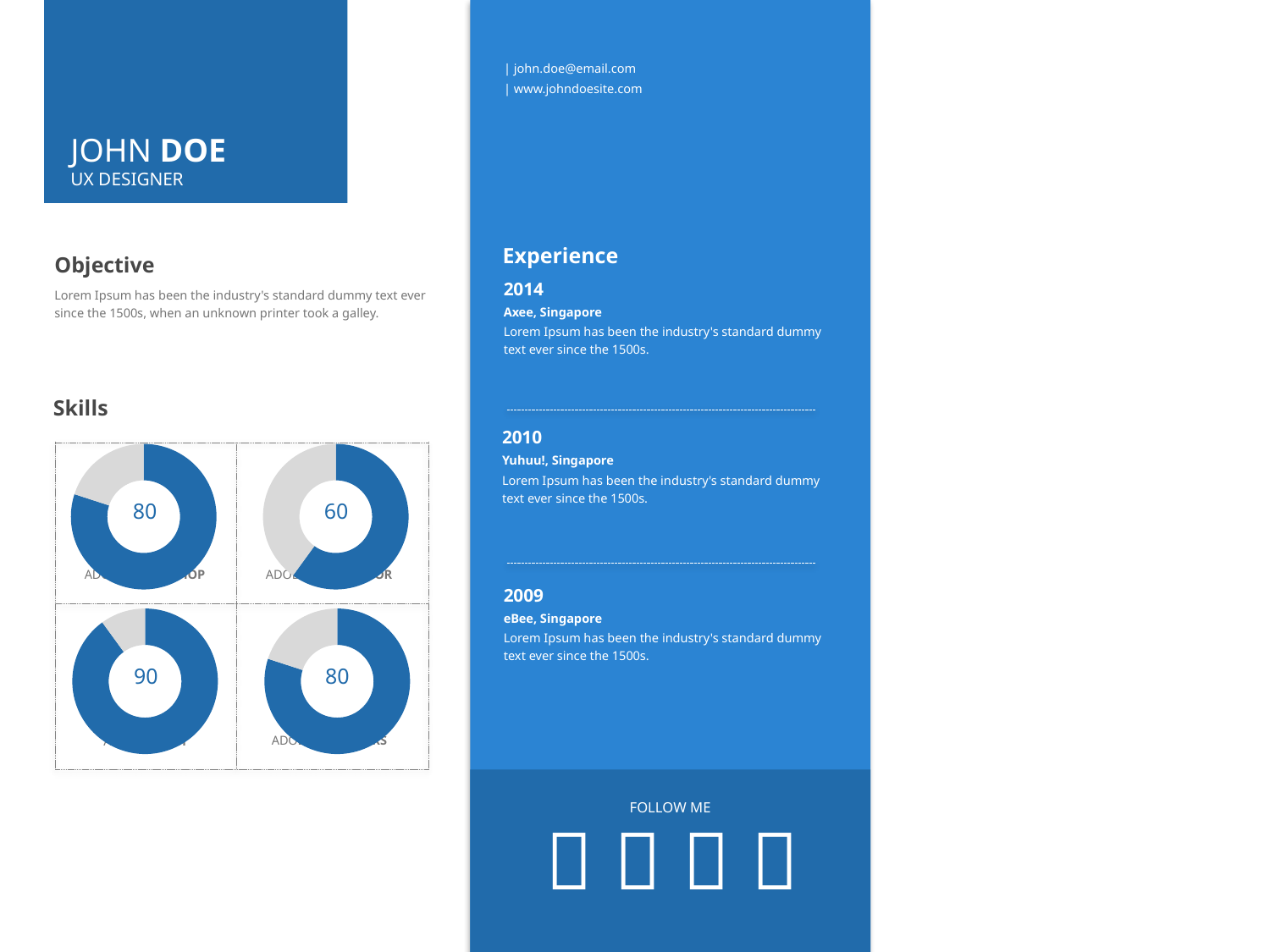
What kind of chart is used for each skill in the Skills section? doughnut chart What colour is the filled portion of the doughnut charts in the Skills section? blue What value is shown in the centre of the top-right doughnut chart in the Skills section? 60 What value is shown in the centre of the top-left doughnut chart in the Skills section? 80 What is the difference between the value in the top-left Skills chart and the value in the top-right Skills chart? 20 Which of the four Skills doughnut charts shows the highest value? bottom-left What value is shown in the centre of the bottom-left doughnut chart in the Skills section? 90 What value is shown in the centre of the bottom-right doughnut chart in the Skills section? 80 How many doughnut charts are shown in the Skills section? 4 Which of the four Skills doughnut charts shows the lowest value? top-right Which is larger, the value in the top-left Skills chart or the value in the top-right Skills chart? top-left What is the difference between the value in the bottom-left Skills chart and the value in the top-right Skills chart? 30